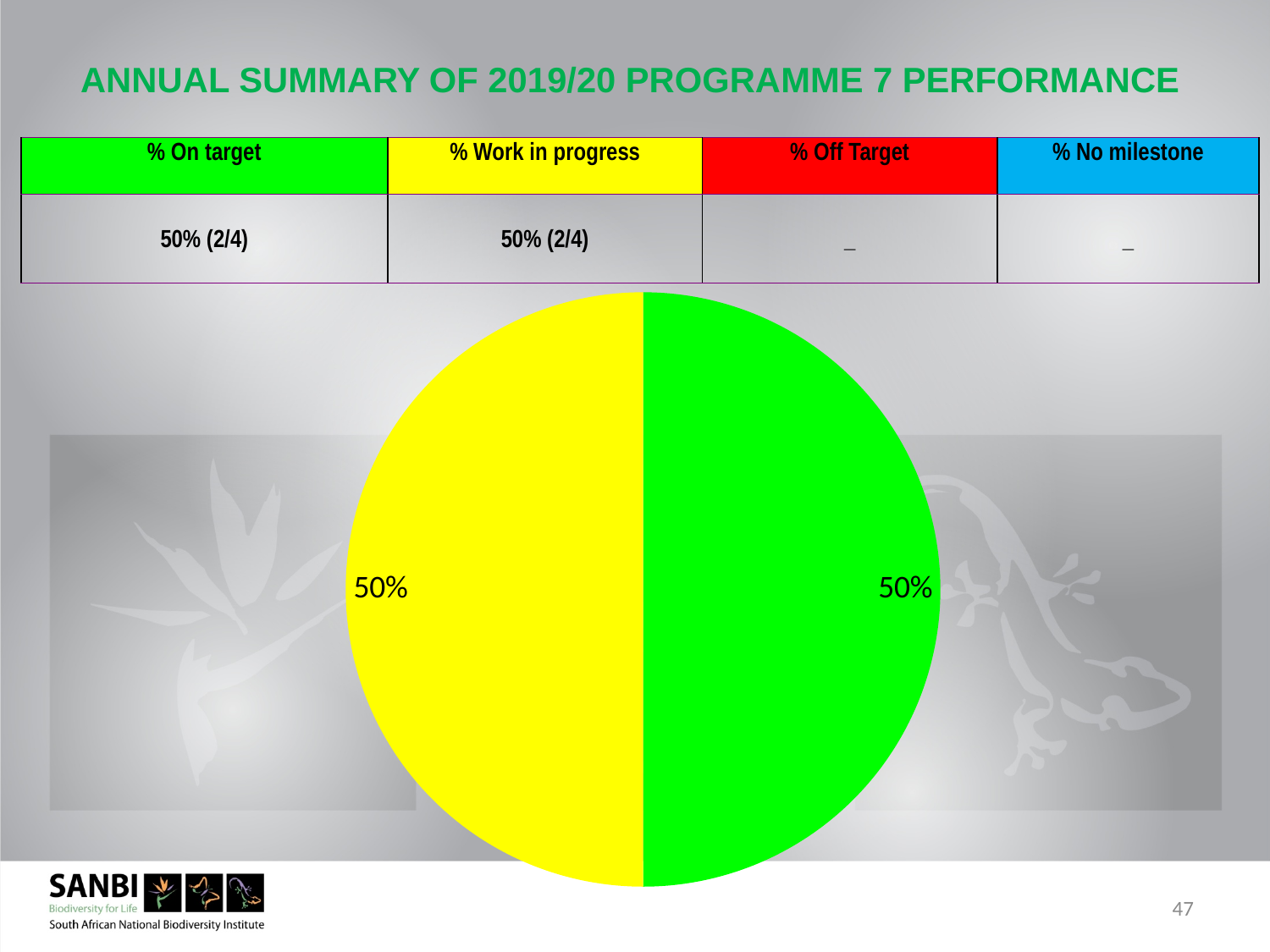
What share of the pie does the yellow slice represent? 50% What is the difference between the green slice and the yellow slice of the pie chart? 0% How many slices does the pie chart have? 2 What value is labelled on the yellow slice of the pie chart? 50% According to the table above the pie chart, which category does the green colour represent? % On target What do the two slices of the pie chart add up to? 100% What share of the pie does the green slice represent? 50% What kind of chart is shown on the slide? pie chart What value is labelled on the green slice of the pie chart? 50% What colour is the slice on the left half of the pie chart? yellow